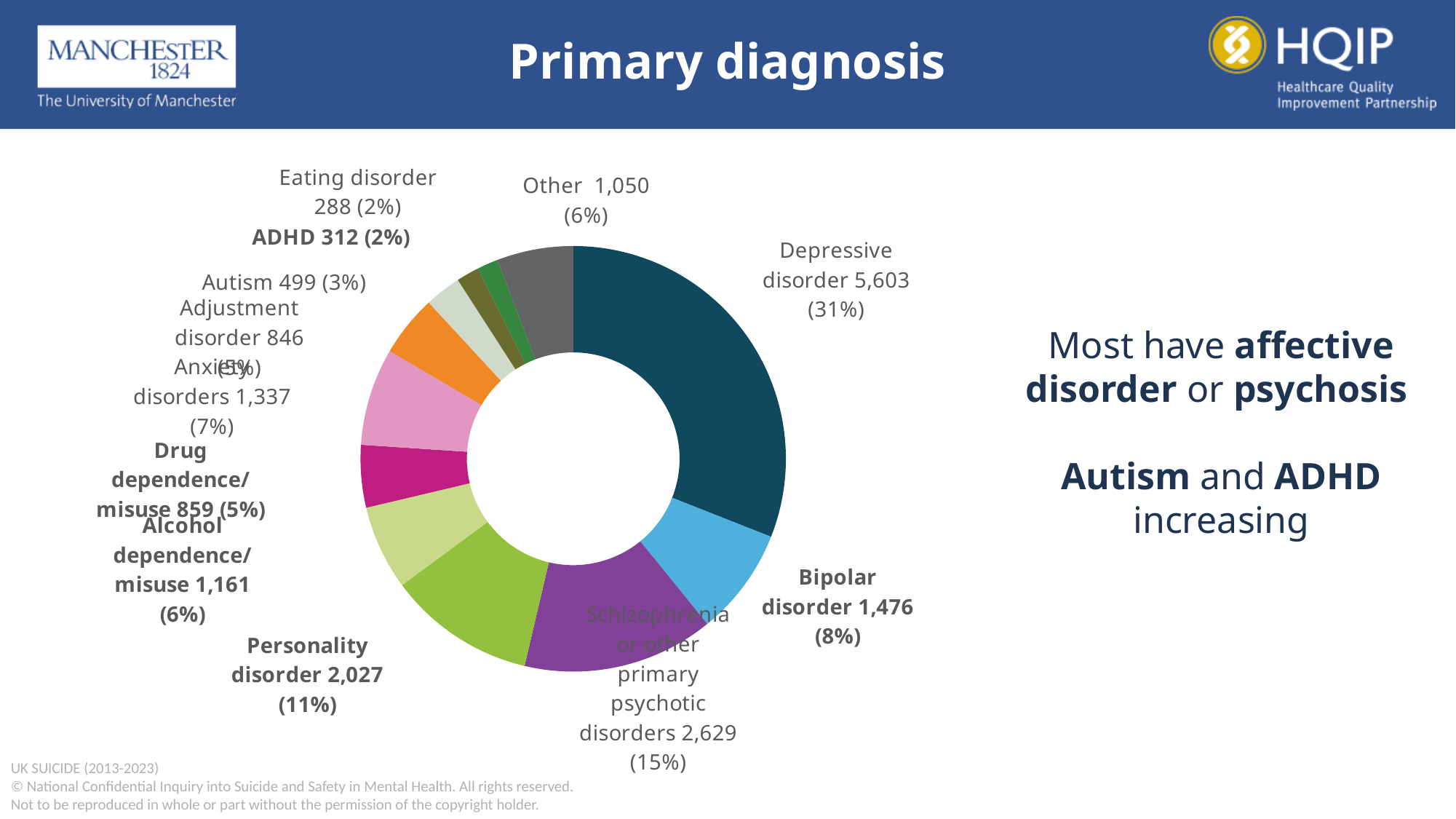
What is the difference between the values for alcohol dependence/misuse and drug dependence/misuse? 302 How many people had a primary diagnosis of depressive disorder? 5,603 What is the value for personality disorder? 2,027 Which primary diagnosis has the smallest slice? Eating disorder Which is larger, the value for autism or the value for ADHD? Autism How many categories are shown in the pie chart? 12 What is the value for schizophrenia or other primary psychotic disorders? 2,629 What is the value for bipolar disorder? 1,476 What share of the pie does anxiety disorders represent? 7% Which primary diagnosis has the largest slice? Depressive disorder What kind of chart is shown on the slide? Doughnut chart What share of the pie does depressive disorder represent? 31%